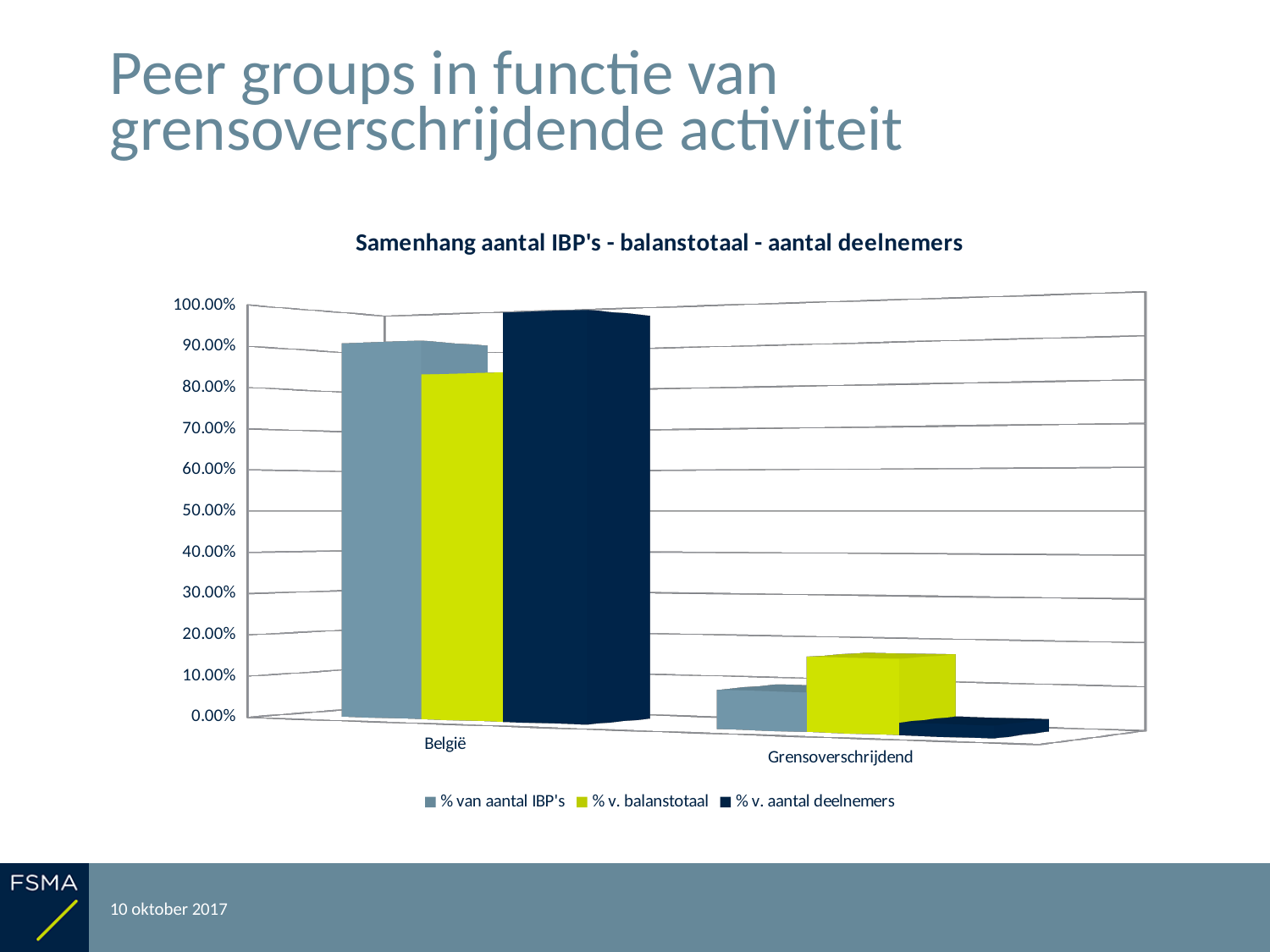
Which category has the higher value for % v. balanstotaal, België or Grensoverschrijdend? België Is the value for % v. balanstotaal for Grensoverschrijdend greater or less than 20.00%? less For Grensoverschrijdend, which series has the highest value? % v. balanstotaal How many series does the chart's legend list? 3 Is the value for % v. aantal deelnemers for België greater or less than 90.00%? greater Is the value for % van aantal IBP's for België greater or less than 80.00%? greater For België, which series has the highest value? % v. aantal deelnemers What kind of chart is shown on the slide? bar chart What is the title of the chart? Samenhang aantal IBP's - balanstotaal - aantal deelnemers Which category has the lower value for % v. aantal deelnemers? Grensoverschrijdend How many categories are shown on the x axis of the chart? 2